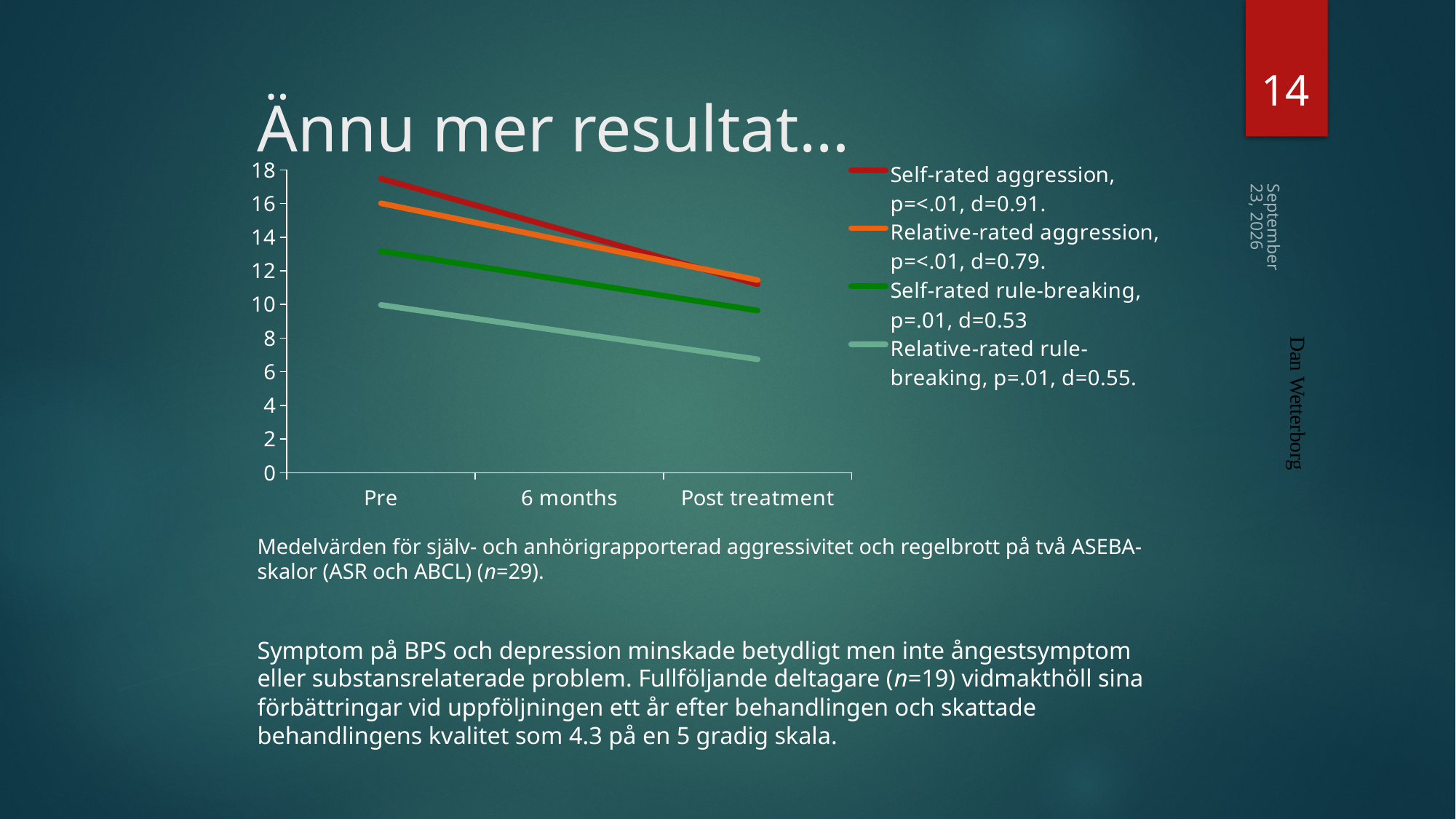
How many categories are shown on the x axis of the chart? 3 Is the value for Self-rated rule-breaking at Pre greater or less than 12? greater Is the value for Relative-rated rule-breaking at Post treatment greater or less than 8? less At Post treatment, which is larger: Self-rated rule-breaking or Relative-rated rule-breaking? Self-rated rule-breaking Is the value for Self-rated aggression at Pre greater or less than 16? greater Which series has the lowest value at Post treatment? Relative-rated rule-breaking, p=.01, d=0.55. Do the values for Self-rated aggression rise or fall from Pre to Post treatment? Fall What kind of chart is shown on the slide? Line chart How many series does the chart's legend list? 4 At Pre, which is larger: Self-rated aggression or Relative-rated aggression? Self-rated aggression Which series has the highest value at Pre? Self-rated aggression, p=<.01, d=0.91. What colour is the line for Self-rated aggression in the chart? Red